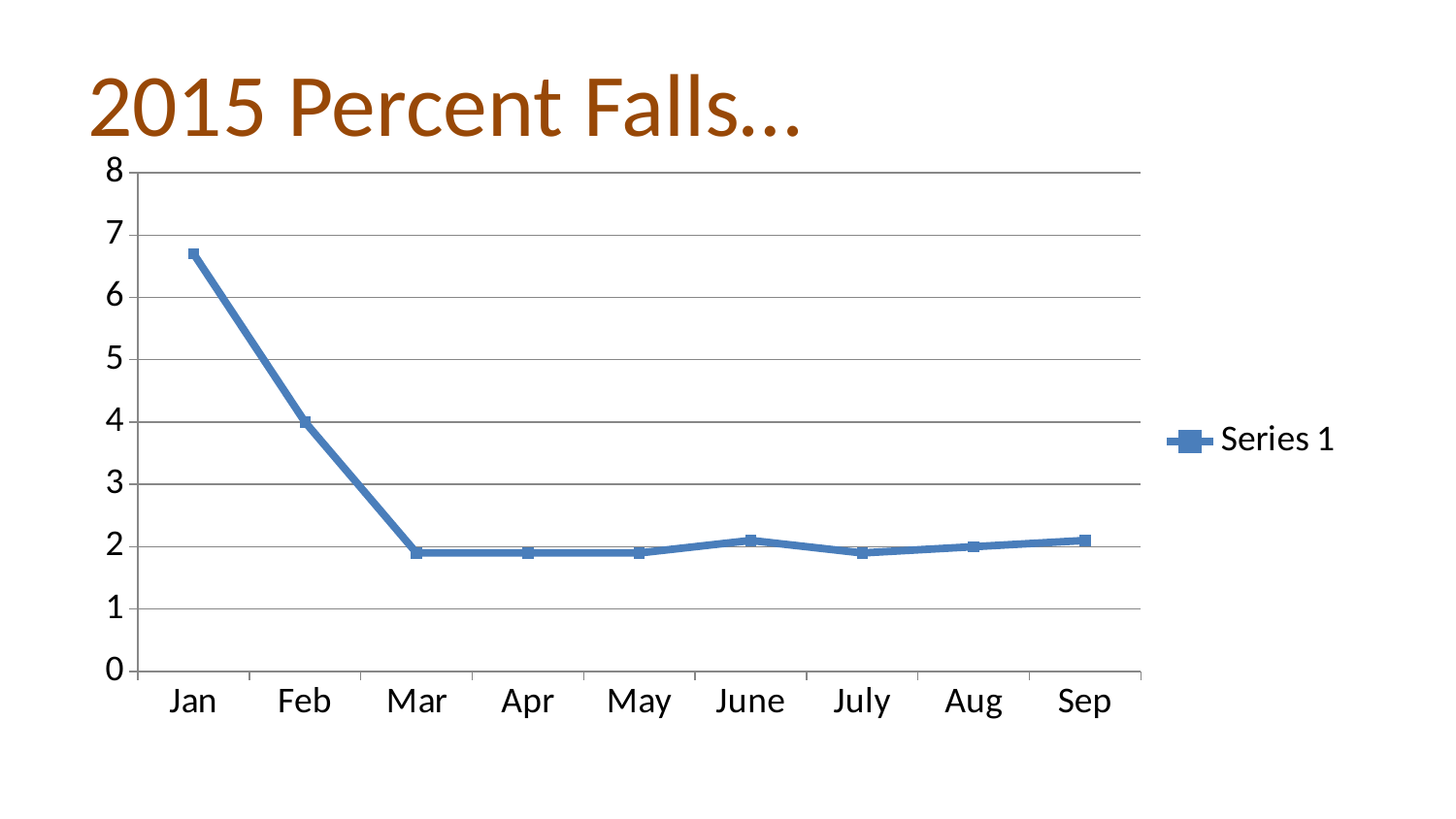
What is the title of the chart? 2015 Percent Falls… How many series does the legend list? 1 Which is larger, the value for Feb or the value for Sep? Feb What is the name of the series shown in the legend? Series 1 How many months are plotted on the x axis? 9 Is the value for Feb greater or less than 5? less Is the value for Jan greater or less than 6? greater Which month has the highest value? Jan What type of chart is shown on the slide? line chart Do the values rise or fall from Jan to Mar? fall Is the value for Mar greater or less than 3? less Which is larger, the value for Jan or the value for Feb? Jan